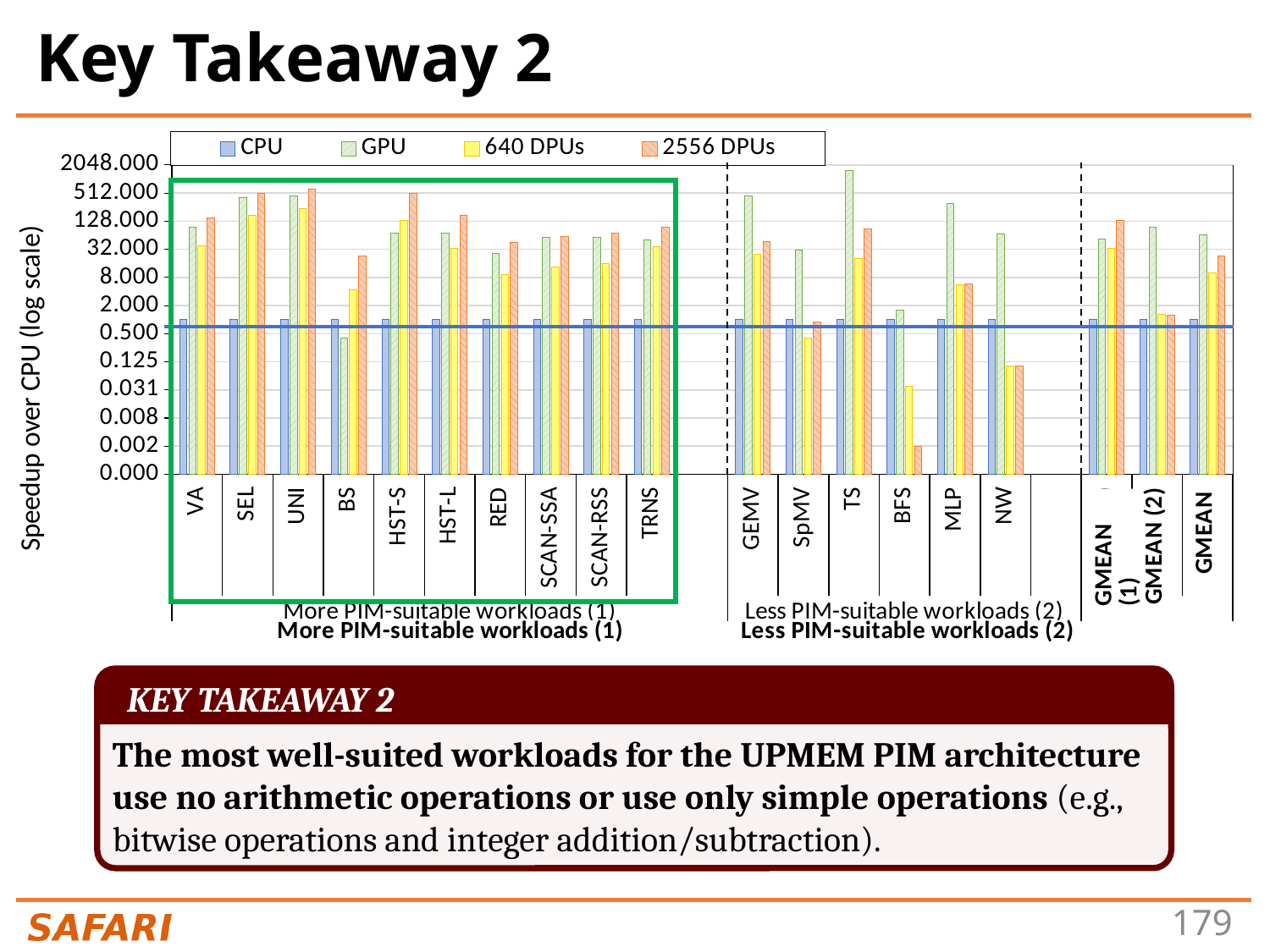
What is the label of the y axis? Speedup over CPU (log scale) For GEMV, which is larger: the GPU value or the 2556 DPUs value? GPU For HST-S, which is larger: the 2556 DPUs value or the GPU value? 2556 DPUs How many workloads are in the 'Less PIM-suitable workloads (2)' group? 6 Is the GPU value for TS greater or less than 512? greater For NW, which is larger: the GPU value or the 640 DPUs value? GPU What kind of chart is shown on the slide? bar chart How many workloads are in the 'More PIM-suitable workloads (1)' group? 10 Is the 2556 DPUs value for BS greater or less than 8? greater Is the 2556 DPUs value for BFS greater or less than 0.125? less How many series does the legend list? 4